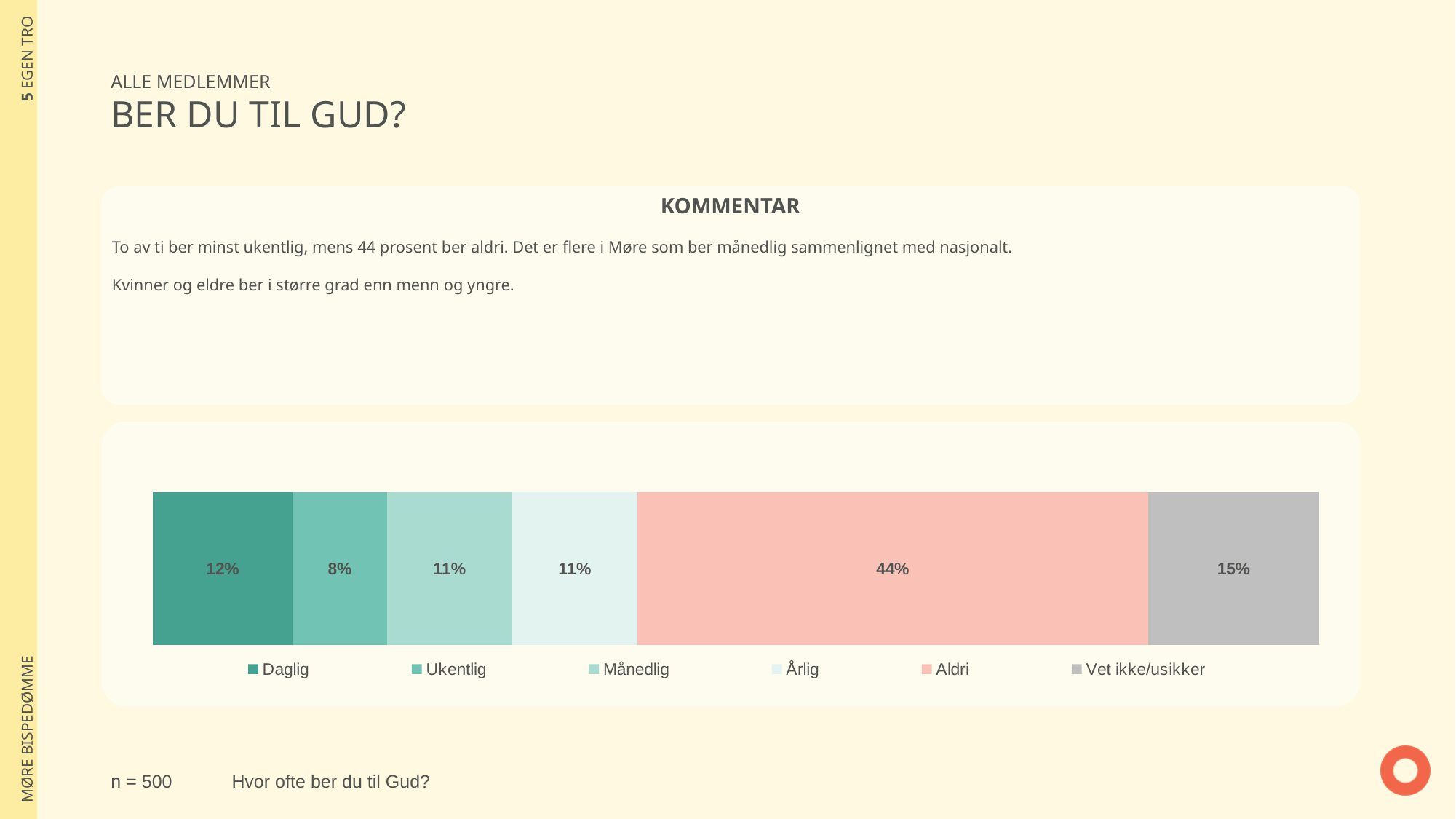
What percentage of respondents answered "Ukentlig"? 8% How many response categories does the legend list? 6 Which is larger, the share for "Daglig" or the share for "Ukentlig"? Daglig What is the combined share of "Daglig" and "Ukentlig"? 20% Which response category has the smallest share? Ukentlig What kind of chart is shown on the slide? Stacked bar chart What is the difference in percentage points between "Aldri" and "Vet ikke/usikker"? 29 What percentage of respondents answered "Vet ikke/usikker"? 15% Which response category has the largest share? Aldri What percentage of respondents answered "Daglig"? 12% What percentage of respondents answered "Aldri"? 44% What is the sample size (n) stated on the slide? n = 500